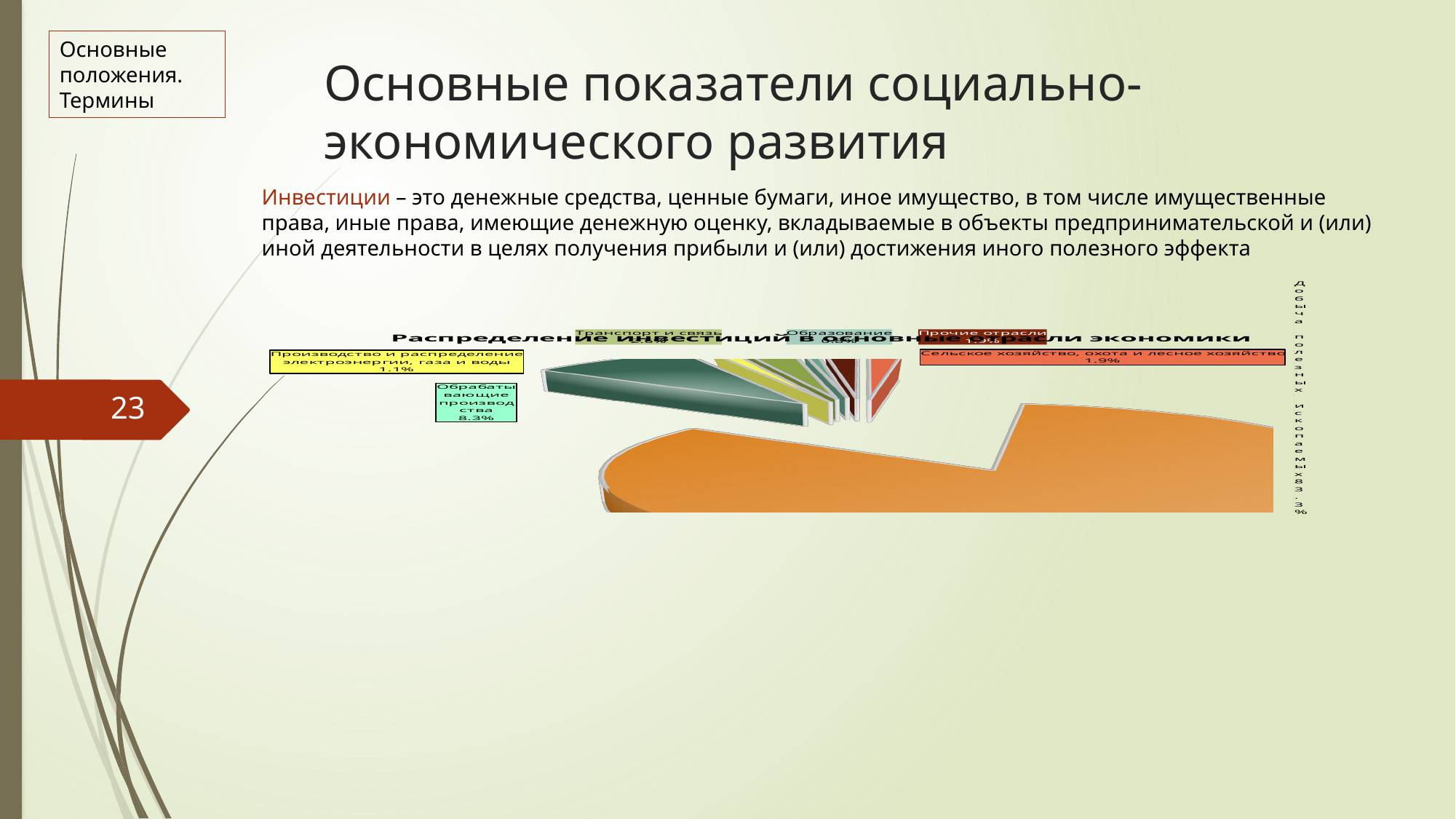
What is the title of the chart? Распределение инвестиций в основные отрасли экономики Which has a larger share: Обрабатывающие производства or Сельское хозяйство, охота и лесное хозяйство? Обрабатывающие производства How many sectors are shown in the pie chart? 7 What is the difference between the shares of Обрабатывающие производства and Сельское хозяйство, охота и лесное хозяйство? 6.4% What share of investments goes to Сельское хозяйство, охота и лесное хозяйство? 1.9% What kind of chart is shown on the slide? pie chart Is the share for Добыча полезных ископаемых greater or less than 50%? greater What share of investments goes to Обрабатывающие производства? 8.3% What share of investments goes to Добыча полезных ископаемых? 83.3% What is the difference between the shares of Добыча полезных ископаемых and Обрабатывающие производства? 75.0% What share of investments goes to Производство и распределение электроэнергии, газа и воды? 1.1% Which sector has the largest share of investments? Добыча полезных ископаемых